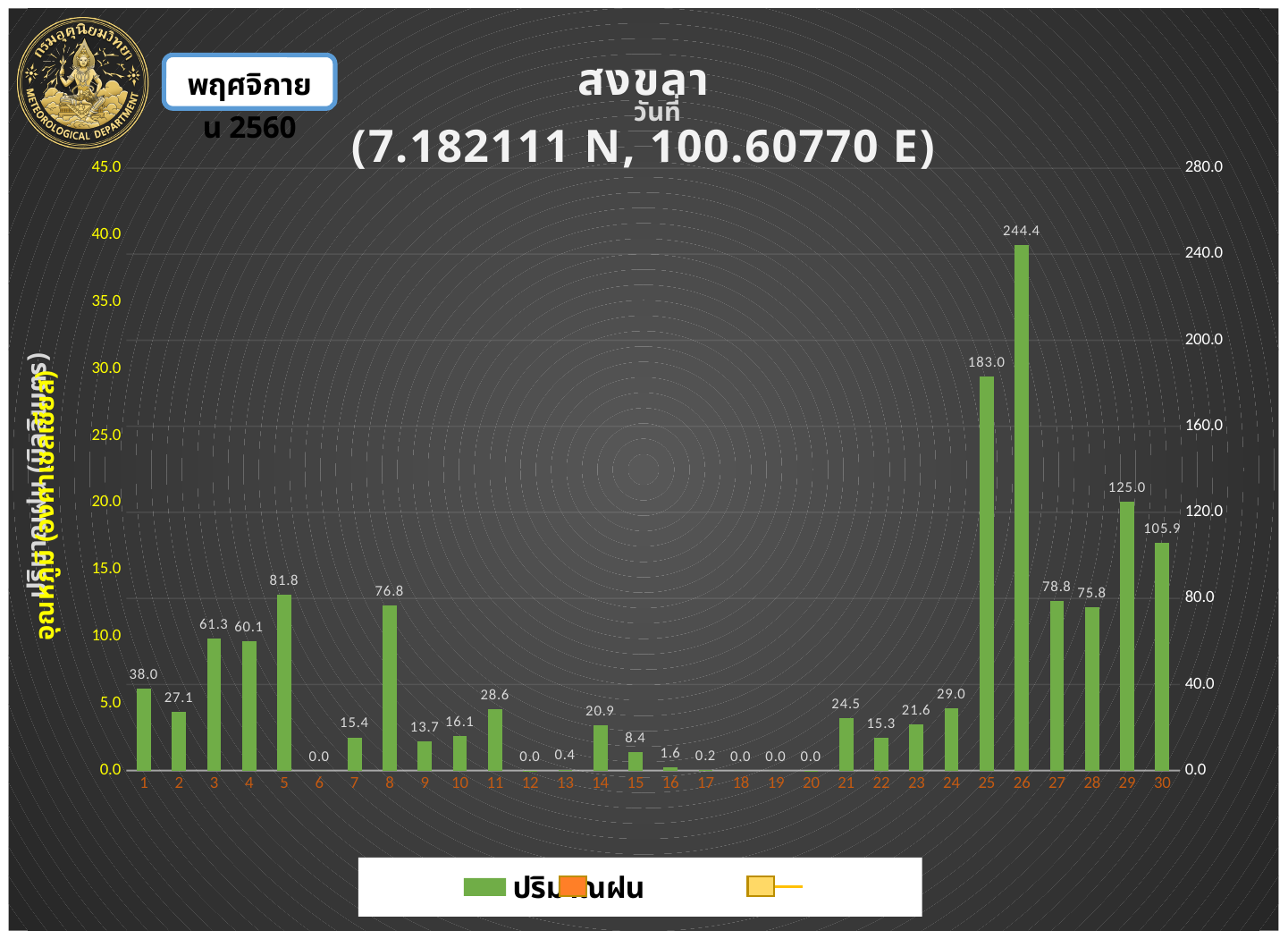
How many days are shown on the x axis? 30 Which is larger, the rainfall value for day 27 or for day 28? day 27 What kind of chart is shown on the slide? bar chart What is the rainfall value shown for day 13? 0.4 What is the difference between the rainfall values for day 26 and day 25? 61.4 What is the rainfall value shown for day 5? 81.8 What coordinates are given in the chart title? 7.182111 N, 100.60770 E Which is larger, the rainfall value for day 3 or for day 4? day 3 What is the rainfall value shown for day 29? 125.0 What is the difference between the rainfall values for day 29 and day 30? 19.1 Which day has the highest rainfall value? 26 What is the rainfall value shown for day 26? 244.4